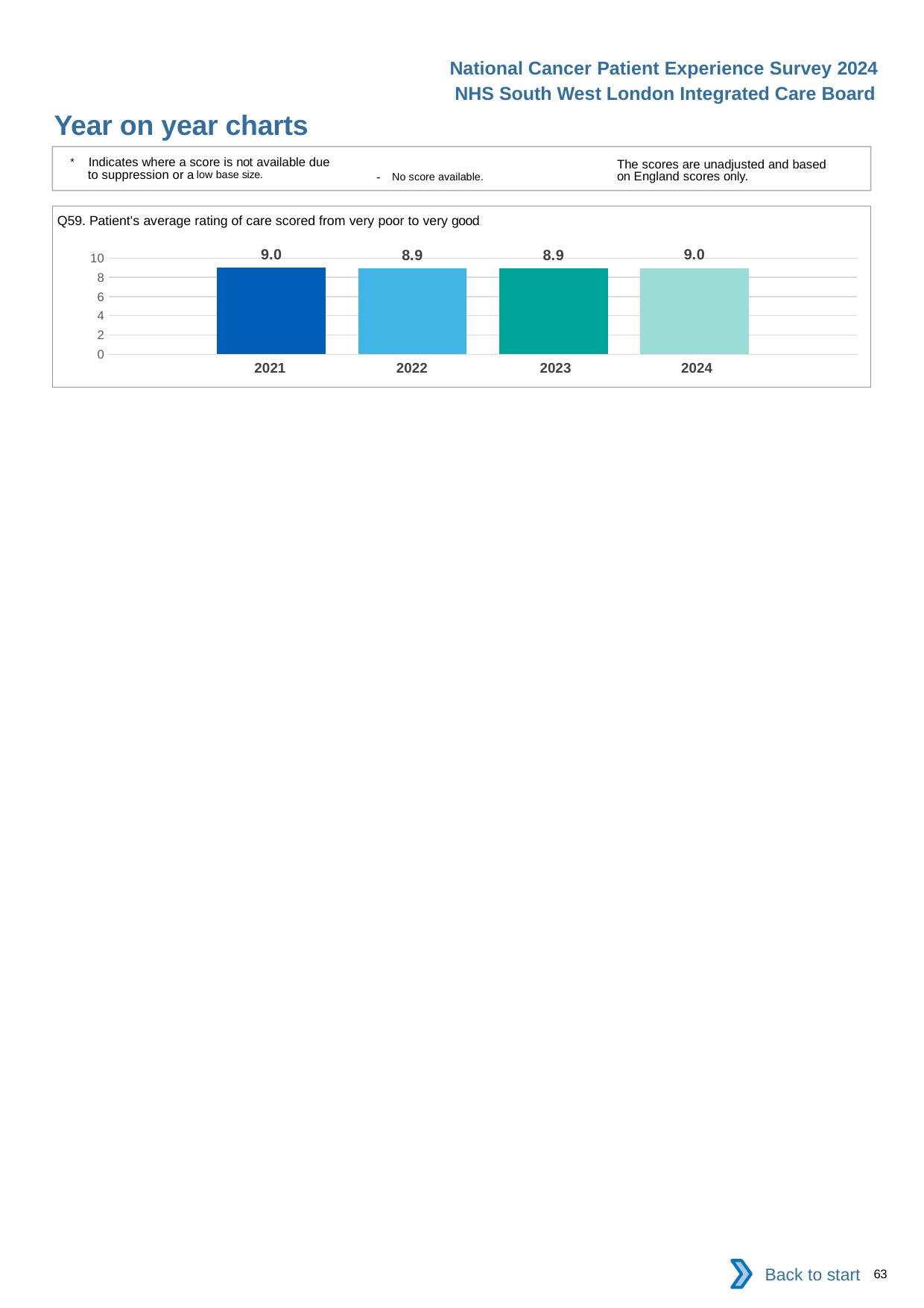
What is the value for 2022? 8.9 What is the value for 2021? 9.0 What is the difference between the values for 2021 and 2022? 0.1 What is the highest value shown on the y axis? 10 What is the difference between the values for 2023 and 2024? 0.1 What is the value for 2023? 8.9 Is the value for 2022 greater or less than 8? greater What kind of chart is this? bar chart What is the title of the chart? Q59. Patient's average rating of care scored from very poor to very good What is the value for 2024? 9.0 Is the value for 2024 greater or less than 10? less How many years are shown on the x axis? 4